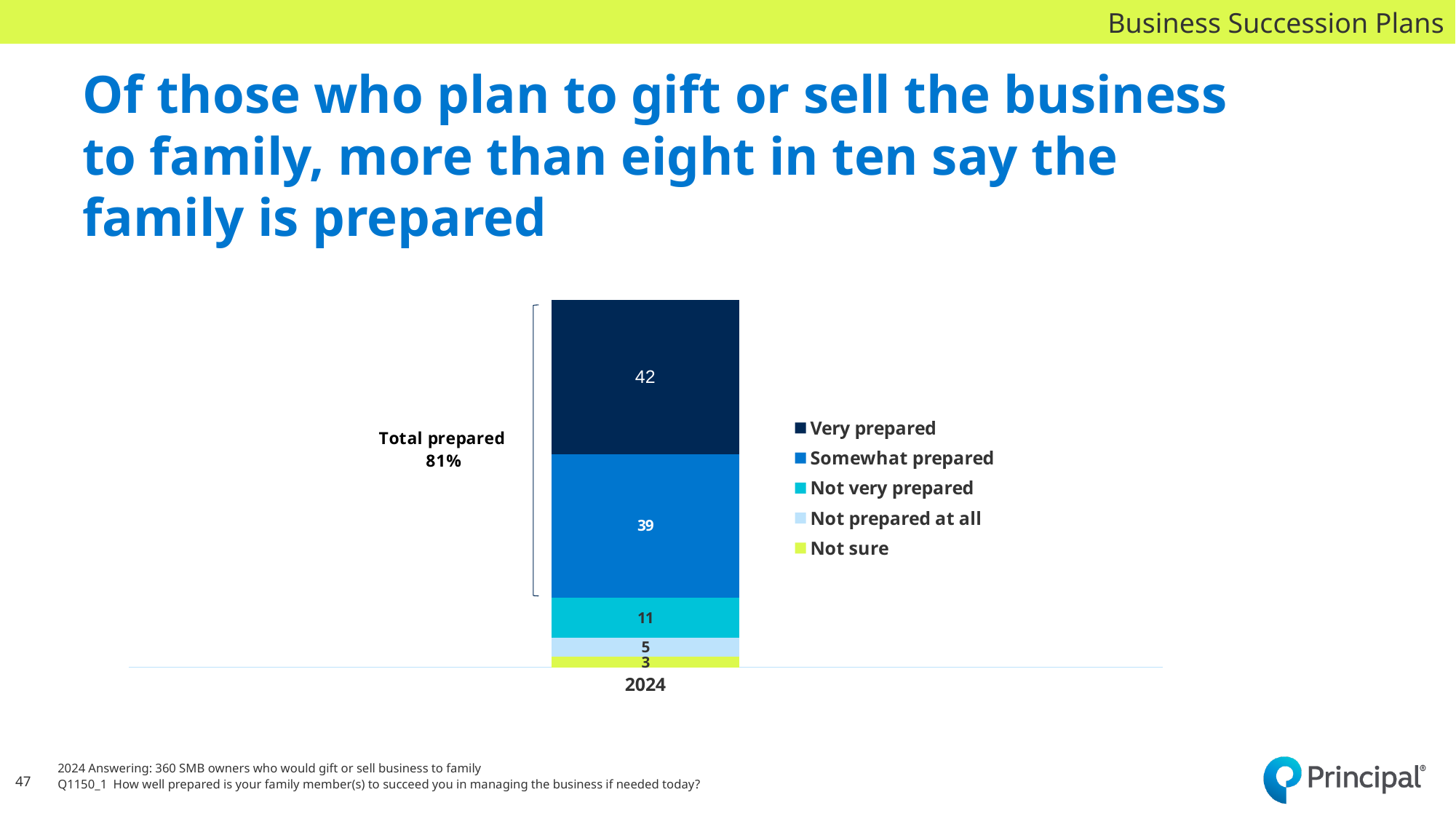
What is the value for Not very prepared in 2024? 11 What is the difference between the Very prepared and Somewhat prepared values? 3 What is the Total prepared percentage shown next to the bar? 81% What is the value for Very prepared in 2024? 42 What kind of chart is shown on the slide? Stacked bar chart How many series does the legend list? 5 What is the value for Somewhat prepared in 2024? 39 Which series has the lowest value in the 2024 bar? Not sure What is the value for Not sure in 2024? 3 What is the value for Not prepared at all in 2024? 5 Which is larger, Not very prepared or Not prepared at all? Not very prepared Which series has the highest value in the 2024 bar? Very prepared